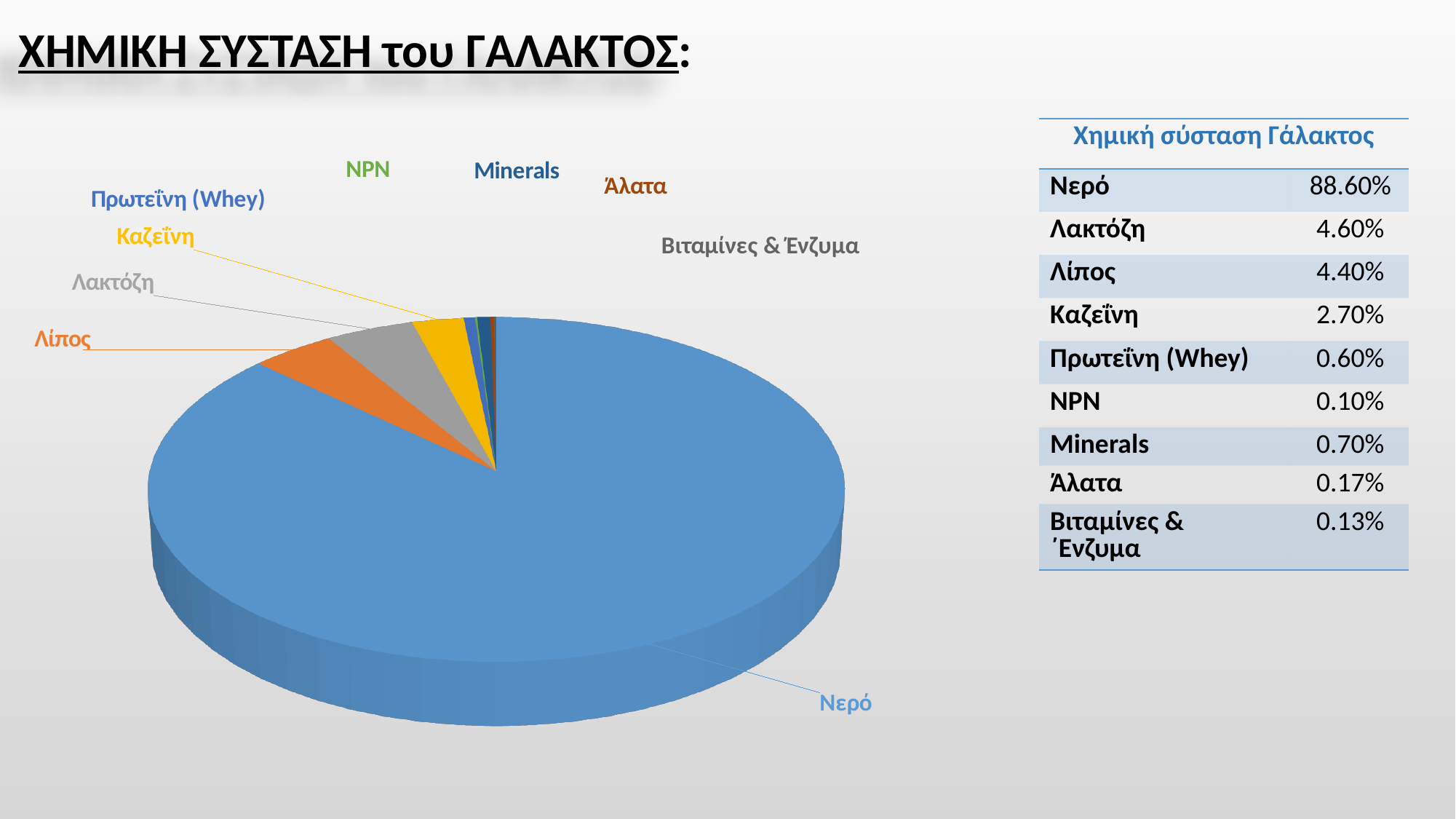
What is the difference between the values for Λακτόζη and Καζεΐνη? 1.90% What is the value for Λακτόζη? 4.60% How many slices does the pie chart have? 9 What kind of chart is shown on the slide? pie chart Which is larger, Λακτόζη or Λίπος? Λακτόζη What is the value for Καζεΐνη? 2.70% Which category has the smallest value, NPN or Άλατα? NPN What colour is the Νερό slice of the pie chart? blue What is the value for Λίπος? 4.40% What is the value for Νερό? 88.60% What is the value for Minerals? 0.70% Which category has the largest slice of the pie chart? Νερό